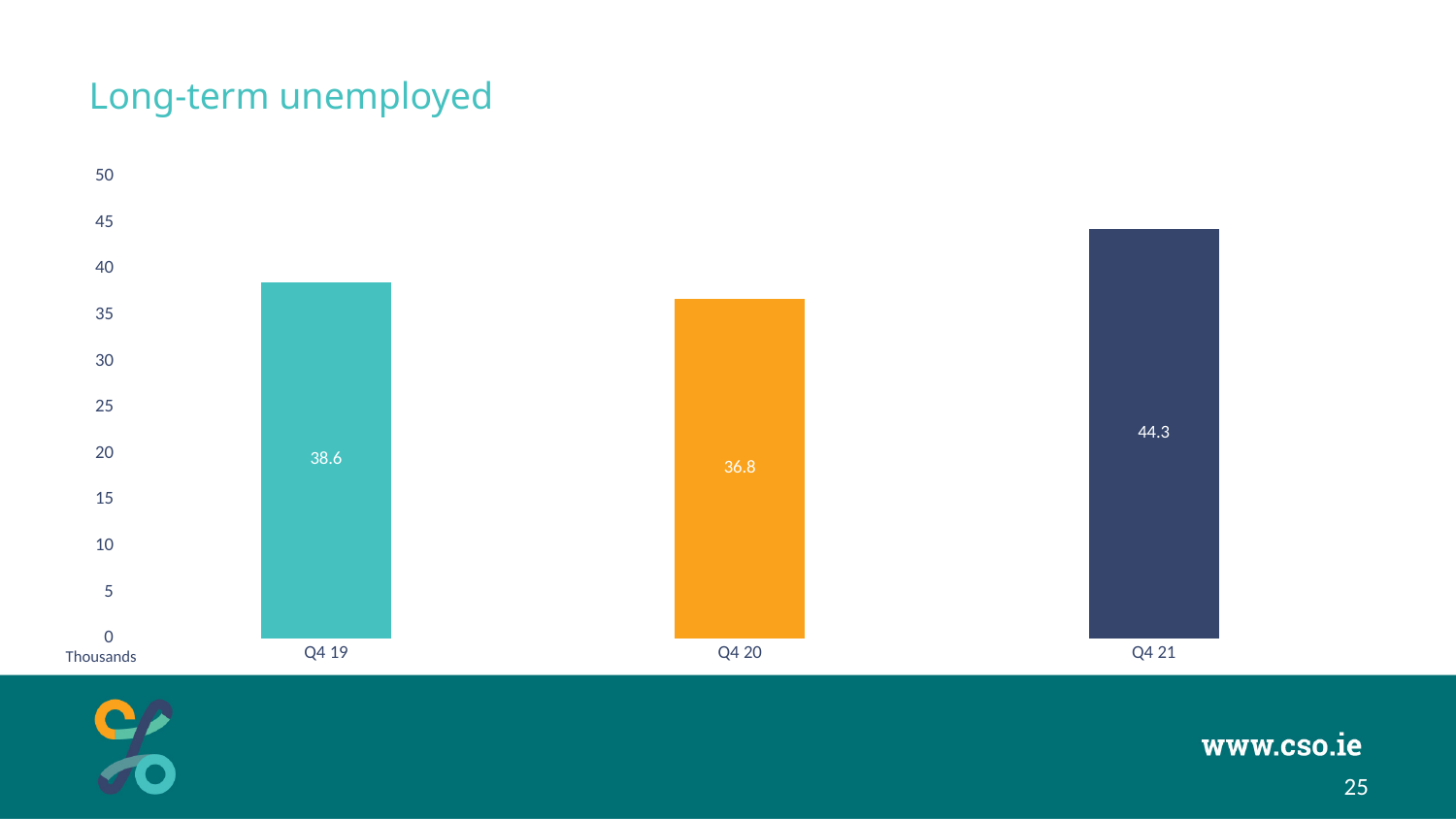
Which quarter has the highest value? Q4 21 What is the value for Q4 19? 38.6 How many categories are shown on the x axis? 3 What is the difference between the values for Q4 21 and Q4 20? 7.5 Which quarter has the lowest value? Q4 20 Is the value for Q4 21 greater or less than 40? greater What kind of chart is shown on the slide? bar chart What is the value for Q4 20? 36.8 Which is larger, the value for Q4 19 or Q4 21? Q4 21 What is the value for Q4 21? 44.3 What is the difference between the values for Q4 19 and Q4 20? 1.8 What is the title of the chart? Long-term unemployed